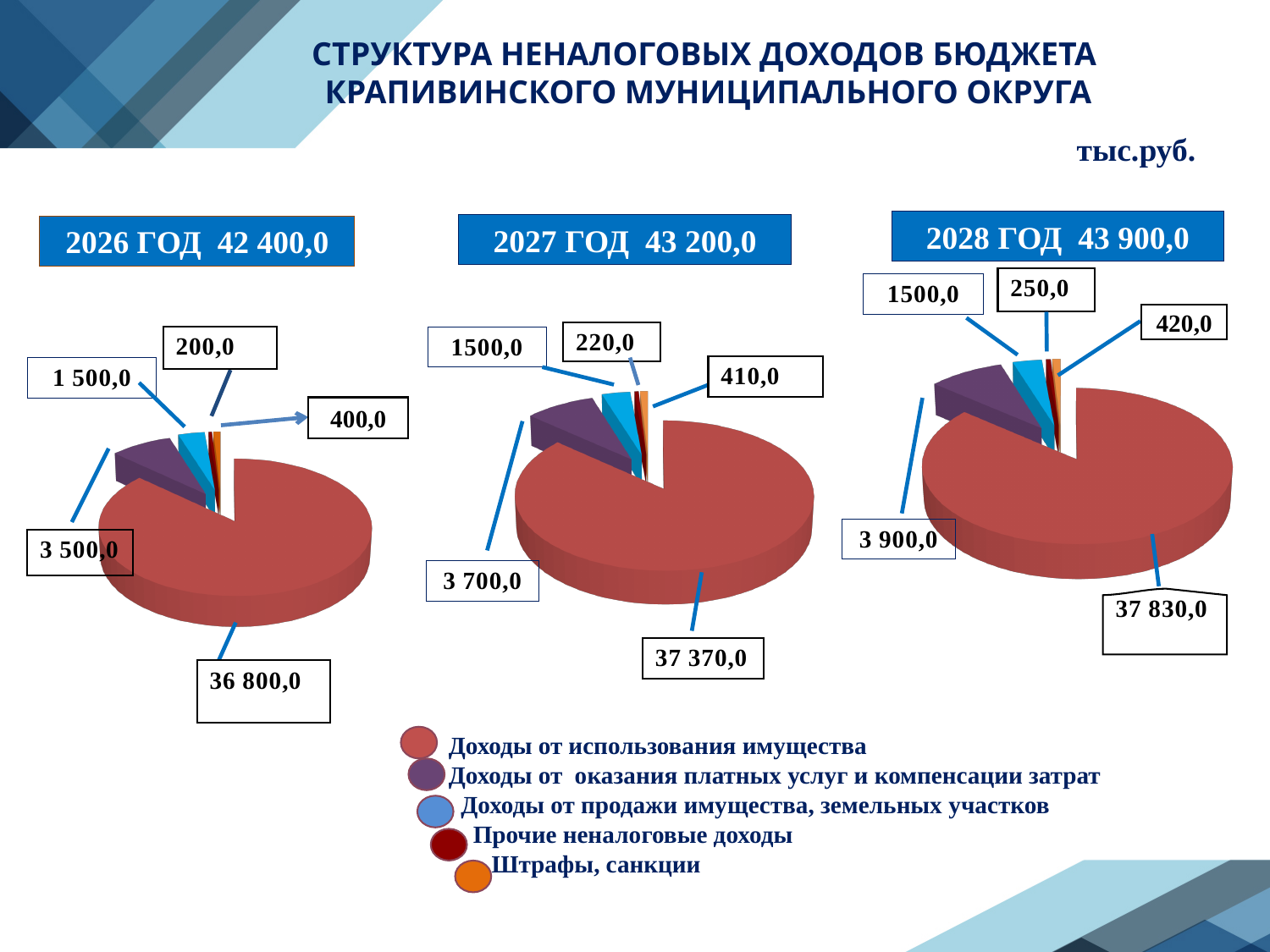
In the 2027 pie chart, which category has the largest slice? Доходы от использования имущества In the 2028 pie chart, what is the value for Доходы от продажи имущества, земельных участков (blue slice)? 1500,0 In the 2027 pie chart, what is the value for Доходы от оказания платных услуг и компенсации затрат (purple slice)? 3 700,0 How many pie charts are on the slide? 3 Which is larger: the Штрафы, санкции slice in 2026 or in 2028? 2028 What is the total shown for the 2028 pie chart? 43 900,0 In the 2026 pie chart, what is the value of the largest slice (Доходы от использования имущества)? 36 800,0 How many categories does the legend list? 5 Does the total of the pie charts rise or fall from 2026 to 2028? Rise In the 2026 pie chart, which category has the smallest slice? Прочие неналоговые доходы What is the difference between the largest slice in 2028 (37 830,0) and the largest slice in 2027 (37 370,0)? 460,0 What kind of charts are shown on the slide? Pie charts